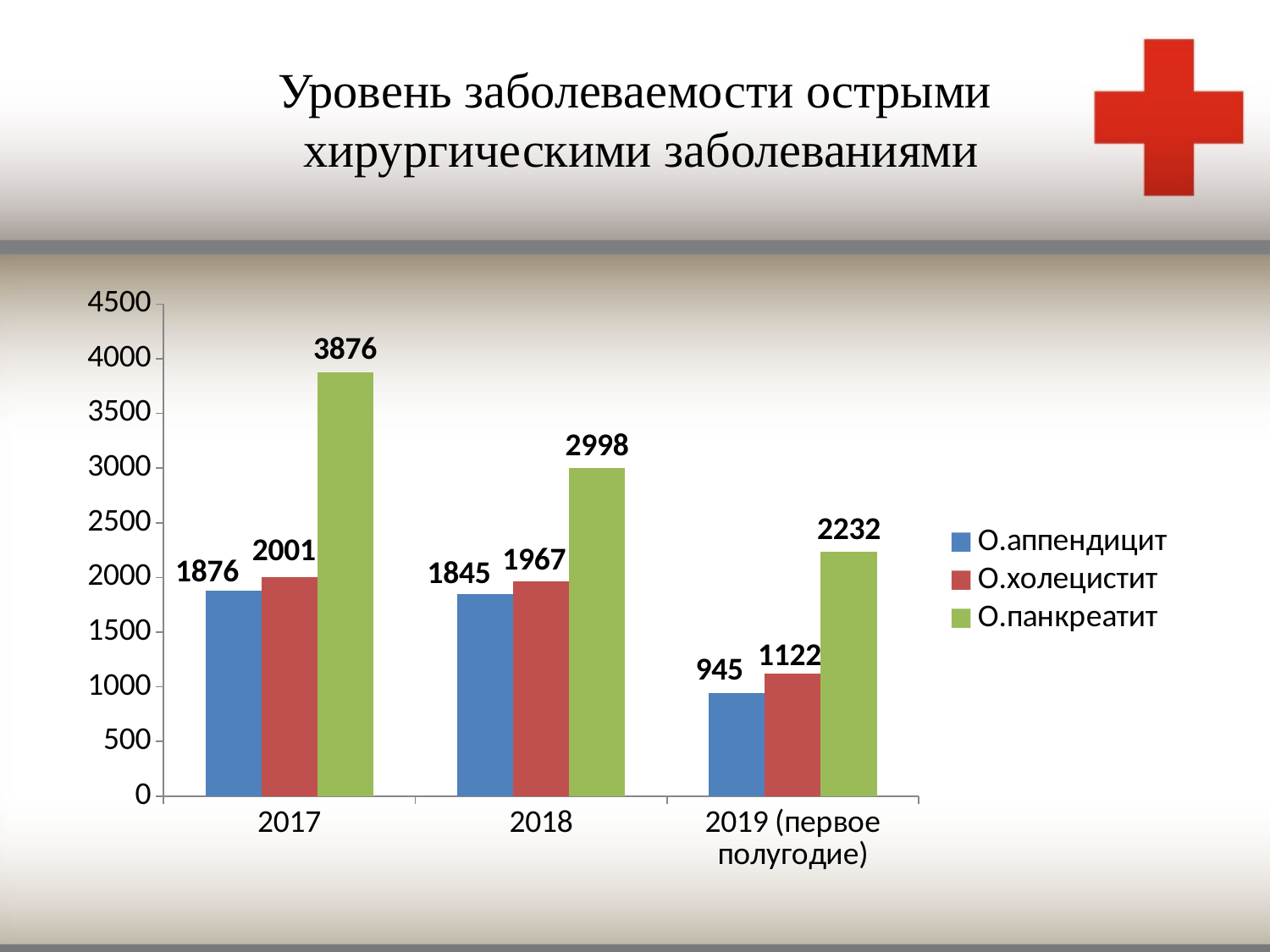
What is the value for О.холецистит in 2018? 1967 Do the values for О.панкреатит rise or fall from 2017 to 2019 (первое полугодие)? Fall What is the difference between О.панкреатит in 2017 and in 2018? 878 What is the value for О.аппендицит in 2019 (первое полугодие)? 945 Which series has the lowest value in 2019 (первое полугодие)? О.аппендицит Which series has the highest value in 2018? О.панкреатит What kind of chart is shown on the slide? Bar chart What is the value for О.панкреатит in 2017? 3876 Which is larger: О.холецистит in 2017 or О.аппендицит in 2017? О.холецистит in 2017 How many categories are shown on the x axis? 3 How many series does the legend list? 3 What colour represents О.холецистит in the legend? Red